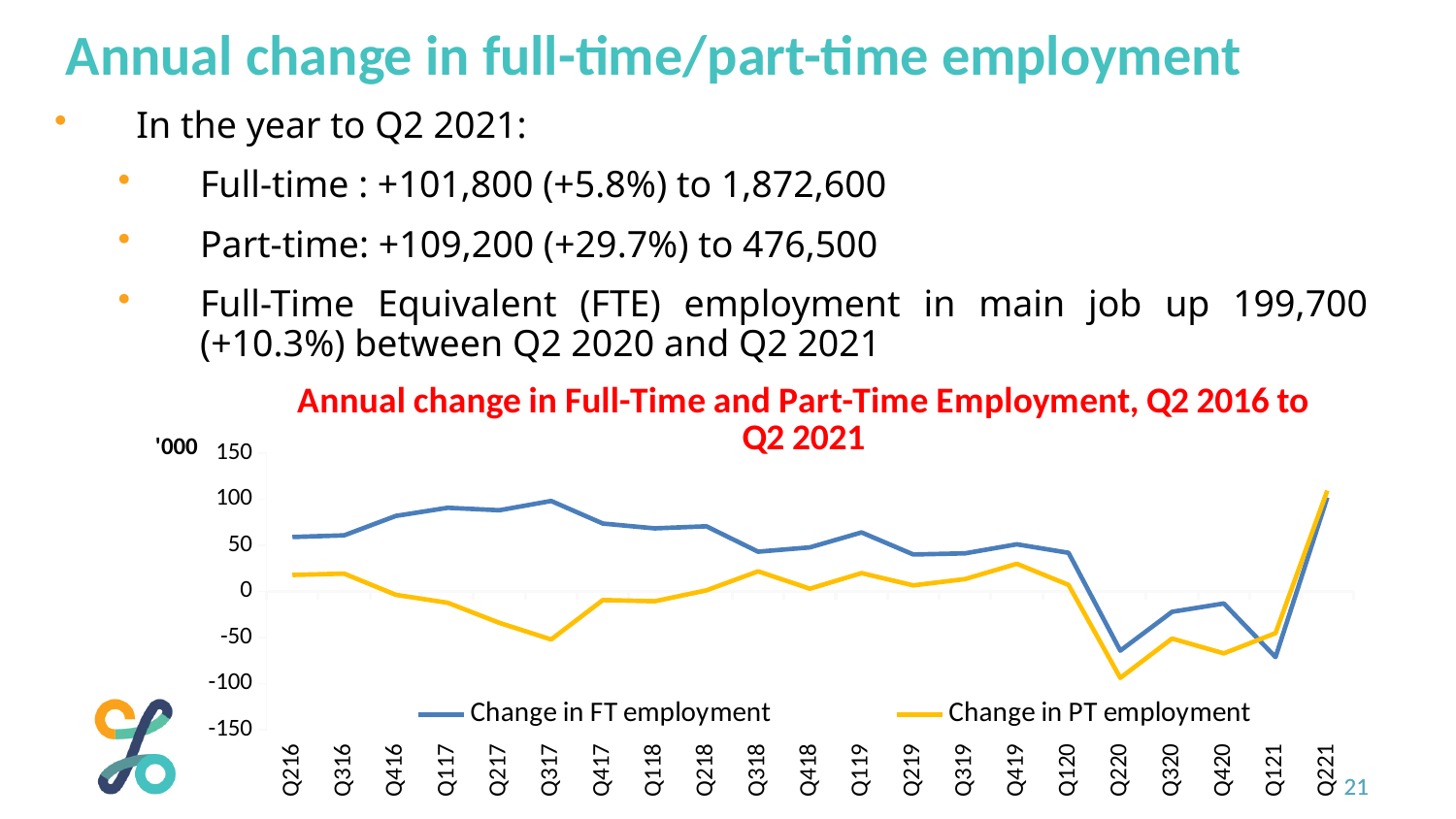
In which quarter does Change in PT employment reach its lowest value? Q220 Is the value for Change in PT employment at Q220 greater or less than -50? less How many quarters are plotted along the x axis of the chart? 21 Which colour is used for the Change in FT employment line? blue At Q216, which series has the larger value: Change in FT employment or Change in PT employment? Change in FT employment Is the value for Change in FT employment at Q221 greater or less than 50? greater Is the value for Change in FT employment at Q220 greater or less than 0? less How many series does the chart's legend list? 2 Does Change in PT employment rise or fall between Q216 and Q317? fall What kind of chart is shown on the slide? line chart In which quarter does Change in PT employment reach its highest value? Q221